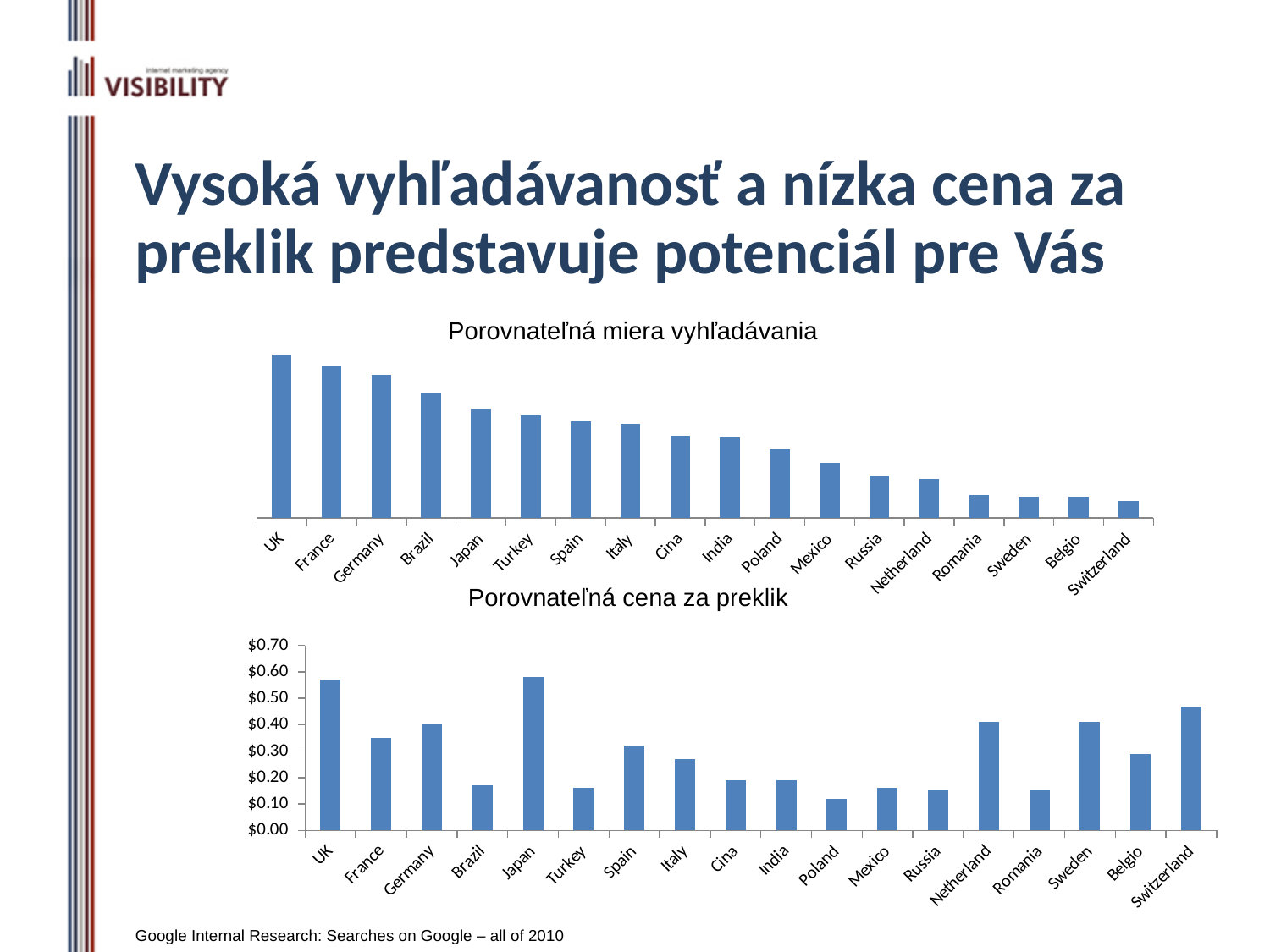
In the bottom chart 'Porovnateľná cena za preklik', is the value for Poland greater or less than $0.20? less In the bottom chart 'Porovnateľná cena za preklik', is the value for Brazil greater or less than $0.20? less In the top chart 'Porovnateľná miera vyhľadávania', which country has the highest value? UK How many countries are shown in the top chart 'Porovnateľná miera vyhľadávania'? 18 In the bottom chart 'Porovnateľná cena za preklik', is the value for Switzerland greater or less than $0.40? greater What is the title of the bottom chart on the slide? Porovnateľná cena za preklik What kind of chart is the bottom chart 'Porovnateľná cena za preklik'? bar chart In the bottom chart 'Porovnateľná cena za preklik', which is larger, the value for Switzerland or the value for Belgio? Switzerland In the top chart 'Porovnateľná miera vyhľadávania', which country has the lowest value? Switzerland In the bottom chart 'Porovnateľná cena za preklik', which is larger, the value for Germany or the value for Turkey? Germany In the top chart 'Porovnateľná miera vyhľadávania', do the values rise or fall from left to right along the x axis? fall